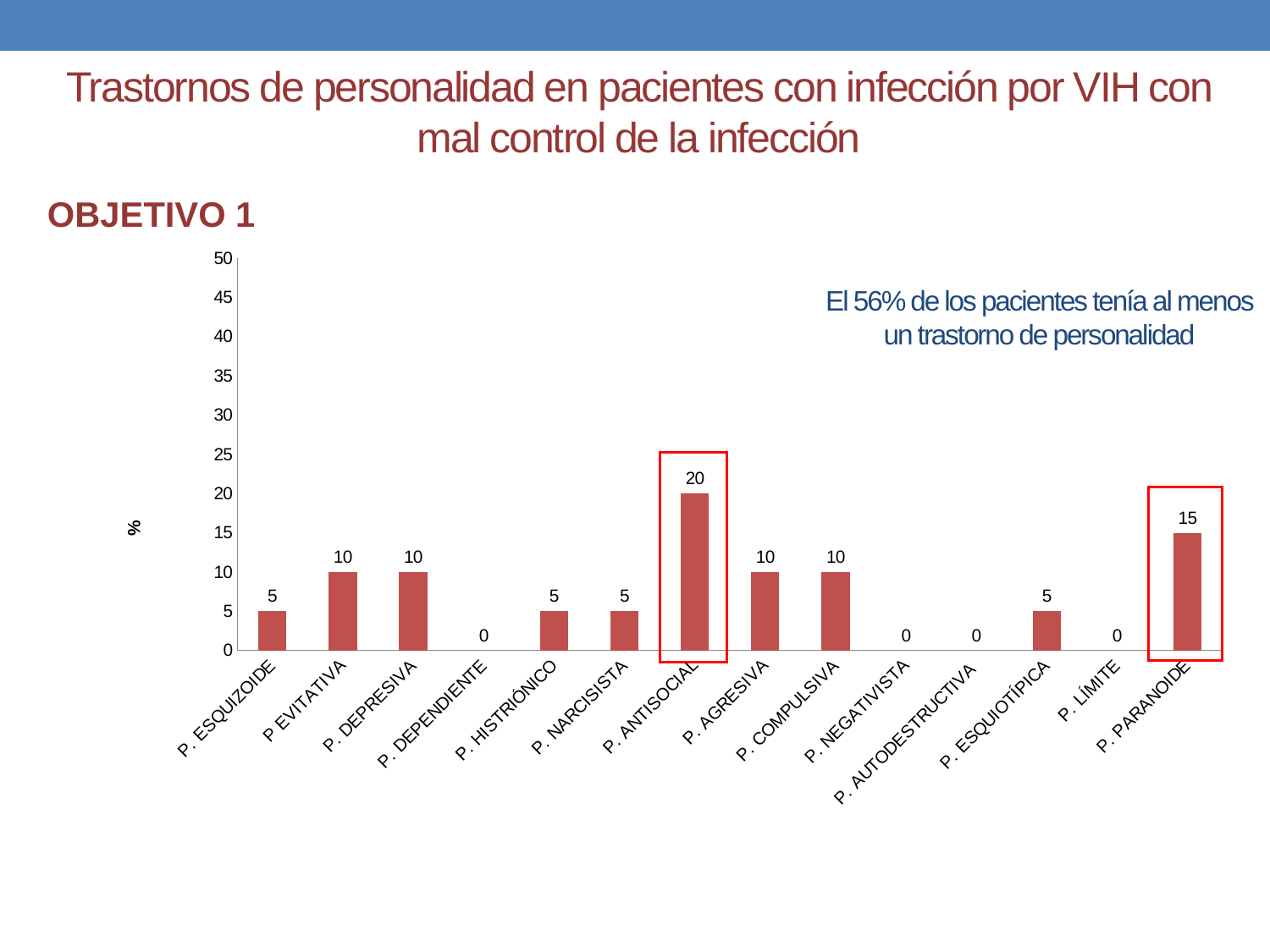
What is the value for P. ANTISOCIAL? 20 What is the difference between the values for P. ANTISOCIAL and P. PARANOIDE? 5 What is the value for P. DEPENDIENTE? 0 What is the value for P. ESQUIZOIDE? 5 Is the value for P. ANTISOCIAL greater or less than 25? less How many categories have a value of 0? 4 What kind of chart is shown on the slide? bar chart What is the difference between the values for P. AGRESIVA and P. NARCISISTA? 5 Which is larger, the value for P. PARANOIDE or the value for P. COMPULSIVA? P. PARANOIDE Which category has the highest value? P. ANTISOCIAL How many categories are shown on the x axis? 14 What is the value for P. PARANOIDE? 15